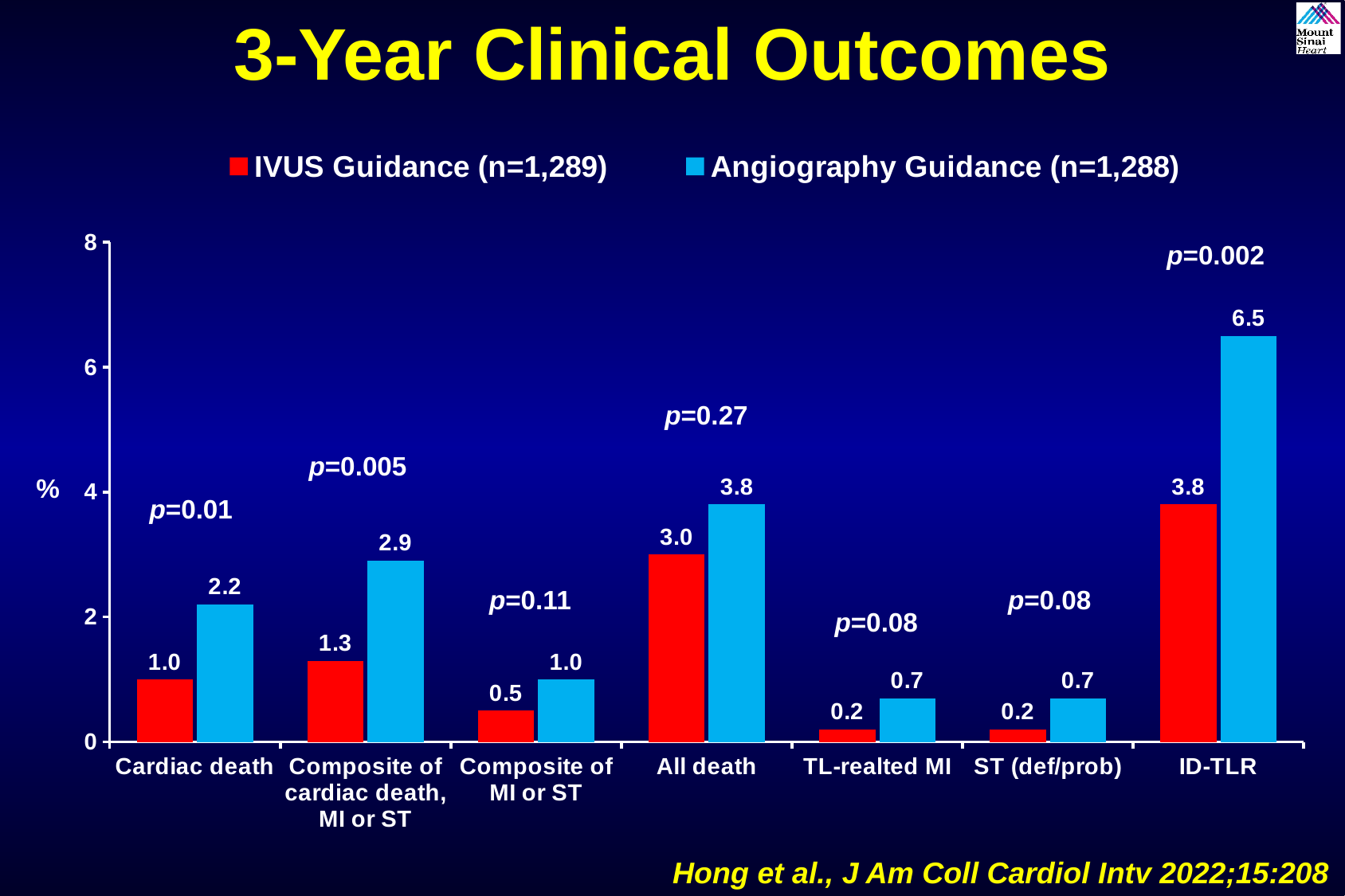
What is the Angiography Guidance value for Composite of cardiac death, MI or ST? 2.9 What is the Angiography Guidance value for ID-TLR? 6.5 How many categories are shown on the x axis? 7 What is the difference between the Angiography Guidance and IVUS Guidance values for All death? 0.8 Which is larger for Cardiac death: the IVUS Guidance value or the Angiography Guidance value? Angiography Guidance Which category has the highest IVUS Guidance value? ID-TLR What kind of chart is shown on the slide? Bar chart What p-value is shown above the ID-TLR bars? p=0.002 What is the IVUS Guidance value for Cardiac death? 1.0 How many series does the legend list? 2 What is the difference between the Angiography Guidance and IVUS Guidance values for ID-TLR? 2.7 Which category has the highest Angiography Guidance value? ID-TLR